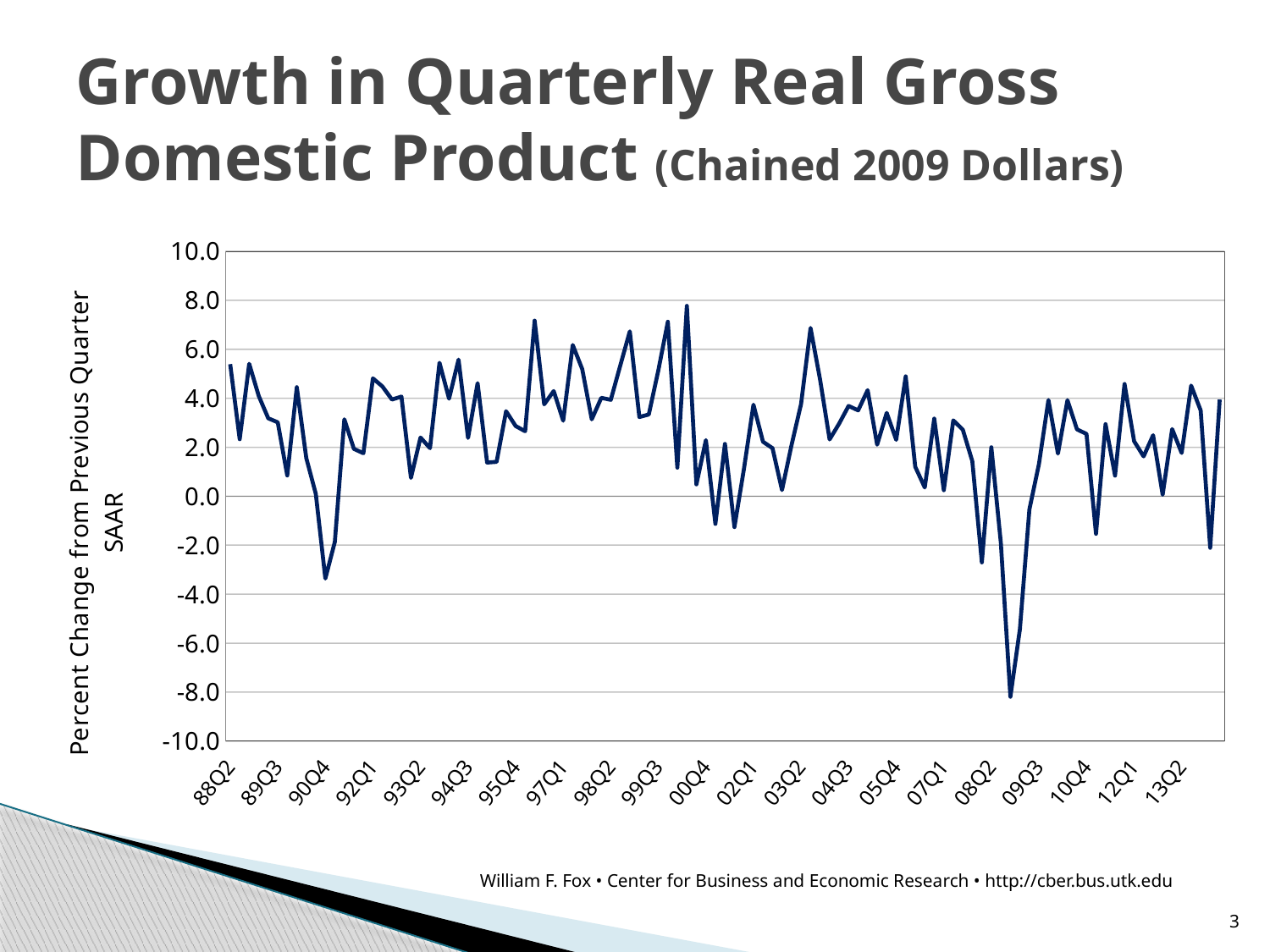
How many quarter labels are shown on the x axis? 21 Is the value for 09Q3 greater or less than -4.0? greater What is the label on the vertical axis of the chart? Percent Change from Previous Quarter SAAR Is the highest value on the chart greater or less than 6.0? greater Is the value for 03Q2 greater or less than 0.0? greater What is the highest value shown on the vertical axis? 10.0 What is the title of the chart on the slide? Growth in Quarterly Real Gross Domestic Product (Chained 2009 Dollars) What kind of chart is shown on the slide? Line chart